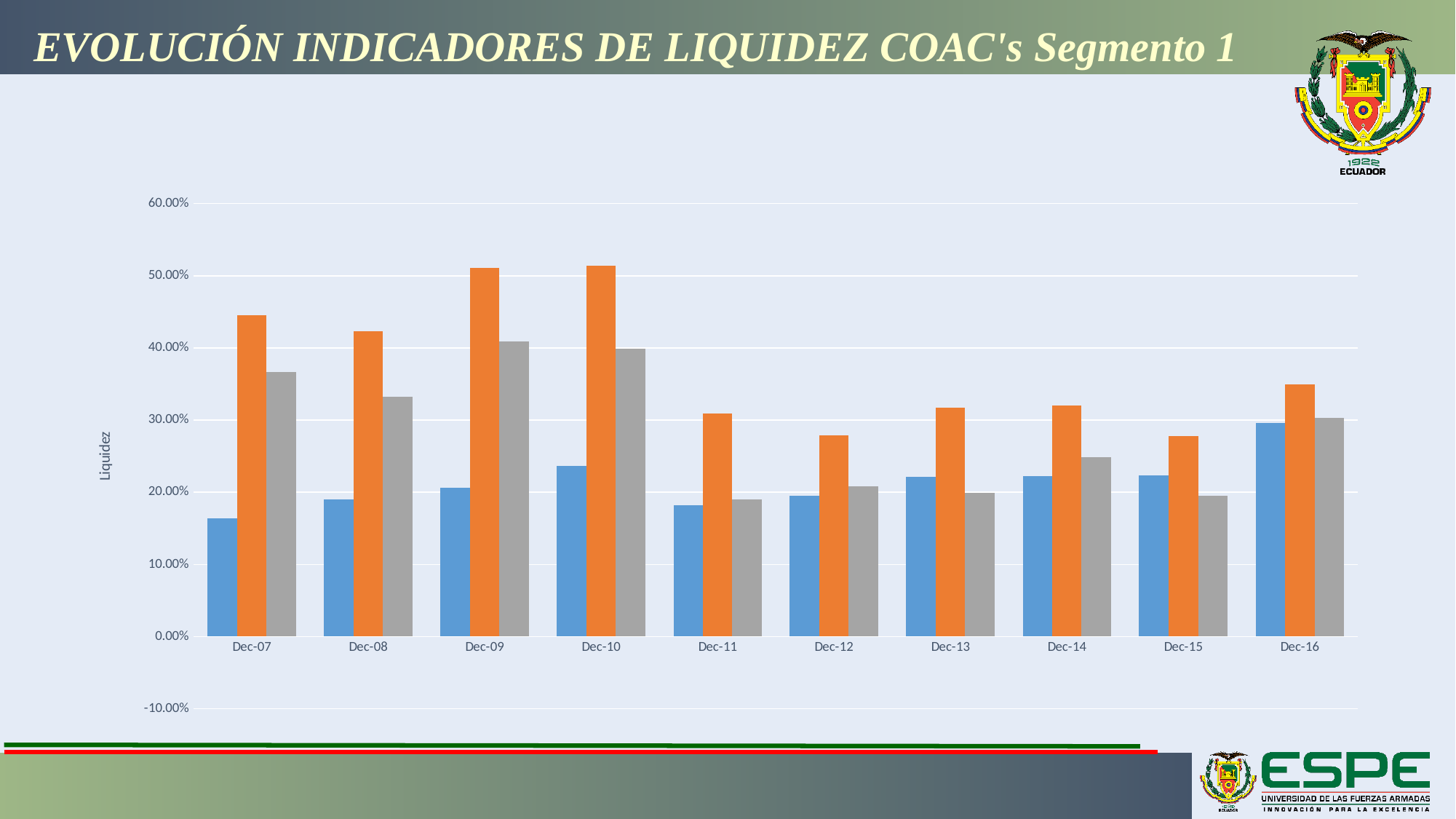
Is the value of the orange bar for Dec-07 greater or less than 40.00%? greater Is the value of the gray bar for Dec-14 greater or less than 20.00%? greater Is the value of the blue bar for Dec-07 greater or less than 20.00%? less What is the label on the vertical axis of the chart? Liquidez In which category is the blue bar the tallest? Dec-16 What is the title of the slide containing the chart? EVOLUCIÓN INDICADORES DE LIQUIDEZ COAC's Segmento 1 What kind of chart is shown on the slide? bar chart Which is larger, the orange bar for Dec-07 or the orange bar for Dec-11? Dec-07 How many categories (dates) are shown on the x axis of the chart? 10 In which category is the blue bar the shortest? Dec-07